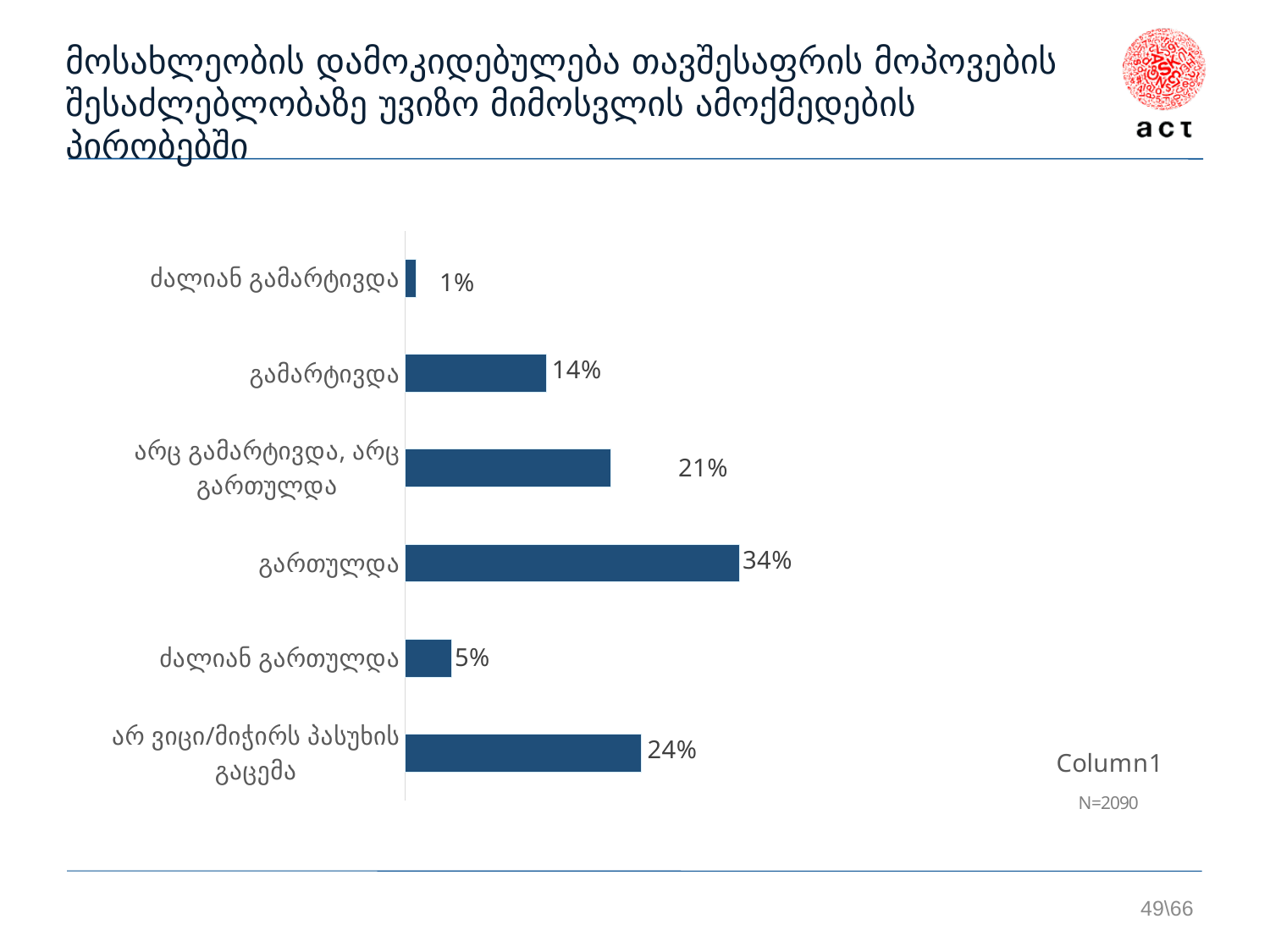
What is the value for "გართულდა"? 34% Which category has the highest value? გართულდა What is the difference between the values for "გართულდა" and "გამარტივდა"? 20% What is the value for "არ ვიცი/მიჭირს პასუხის გაცემა"? 24% How many categories are shown in the chart? 6 What is the value for "ძალიან გამარტივდა"? 1% Which is larger, the value for "ძალიან გართულდა" or the value for "გამარტივდა"? გამარტივდა Which category has the lowest value? ძალიან გამარტივდა What is the legend entry shown on the chart? Column1 What sample size (N) is shown on the slide? N=2090 What kind of chart is shown on the slide? bar chart What is the value for "არც გამარტივდა, არც გართულდა"? 21%